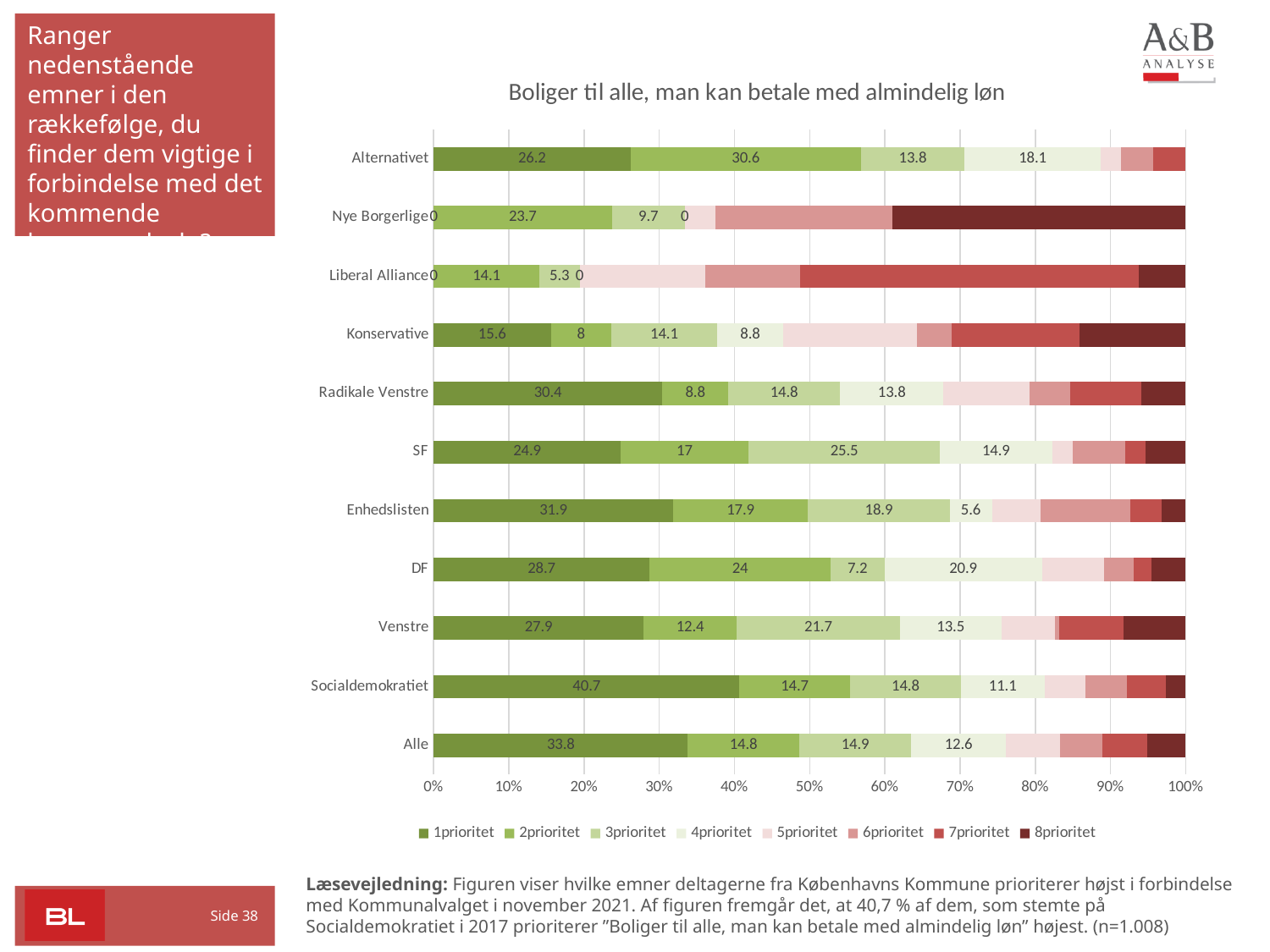
Which party has the highest 1prioritet value? Socialdemokratiet What is the 2prioritet value for Alternativet? 30.6 What kind of chart is shown on the slide? Stacked bar chart Which party has the lowest 2prioritet value? Konservative What is the title of the chart? Boliger til alle, man kan betale med almindelig løn Which is larger, the 1prioritet value for Enhedslisten or for Radikale Venstre? Enhedslisten What is the 3prioritet value for SF? 25.5 What is the 4prioritet value for DF? 20.9 How many series does the legend list? 8 What is the difference between the 1prioritet values for Socialdemokratiet and Alle? 6.9 What is the 1prioritet value for Socialdemokratiet? 40.7 How many parties/categories are shown on the y axis? 11